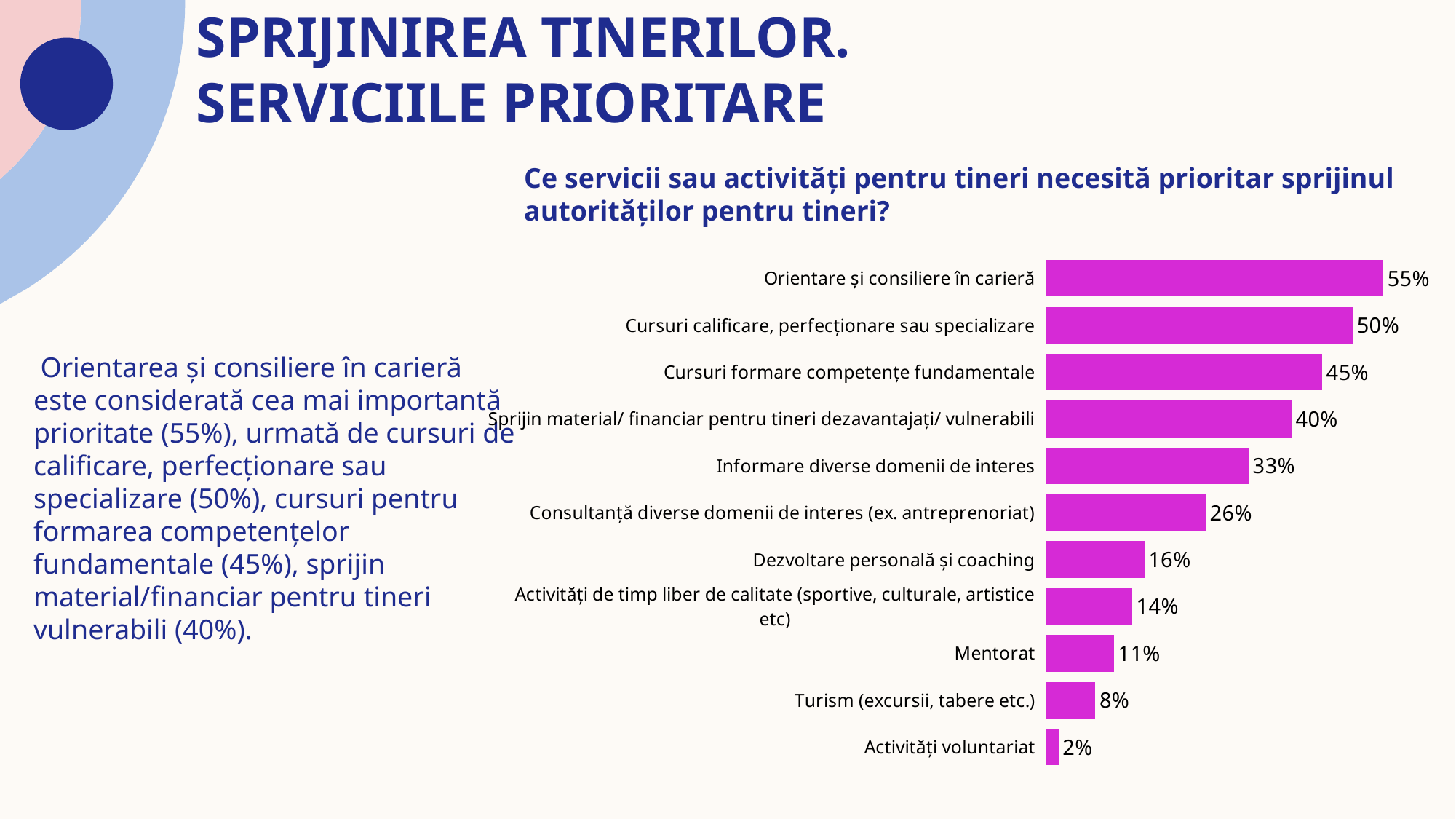
What kind of chart is shown on the slide? Bar chart Which category has the highest value? Orientare și consiliere în carieră Which category has the lowest value? Activități voluntariat What is the difference between "Sprijin material/ financiar pentru tineri dezavantajați/ vulnerabili" and "Dezvoltare personală și coaching"? 24% How many categories are shown in the chart? 11 Which is larger: "Consultanță diverse domenii de interes (ex. antreprenoriat)" or "Activități de timp liber de calitate (sportive, culturale, artistice etc)"? Consultanță diverse domenii de interes (ex. antreprenoriat) What is the difference between "Cursuri calificare, perfecționare sau specializare" and "Cursuri formare competențe fundamentale"? 5% What is the value for "Informare diverse domenii de interes"? 33% What is the value for "Mentorat"? 11% What is the value for "Turism (excursii, tabere etc.)"? 8% What is the value for "Orientare și consiliere în carieră"? 55% What colour are the bars in the chart? Magenta